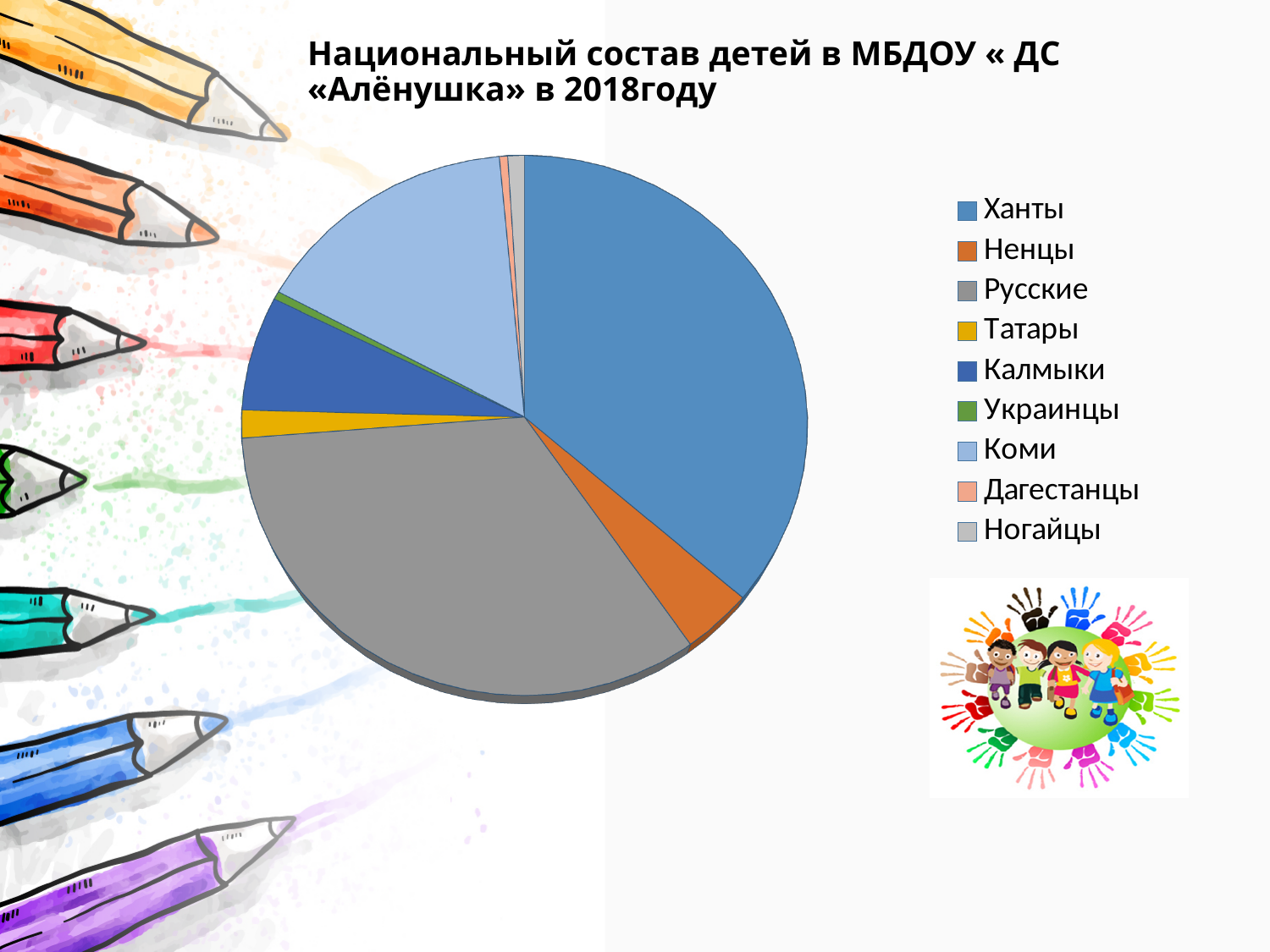
Which slice is larger, Коми or Калмыки? Коми What kind of chart is shown on the slide? Pie chart Which slice is larger, Ненцы or Татары? Ненцы What is the title of the chart? Национальный состав детей в МБДОУ « ДС «Алёнушка» в 2018году What colour is the slice for Татары in the pie chart? Yellow Which slice is larger, Русские or Коми? Русские How many nationalities (categories) does the pie chart's legend list? 9 Which nationality has the largest slice of the pie chart? Ханты